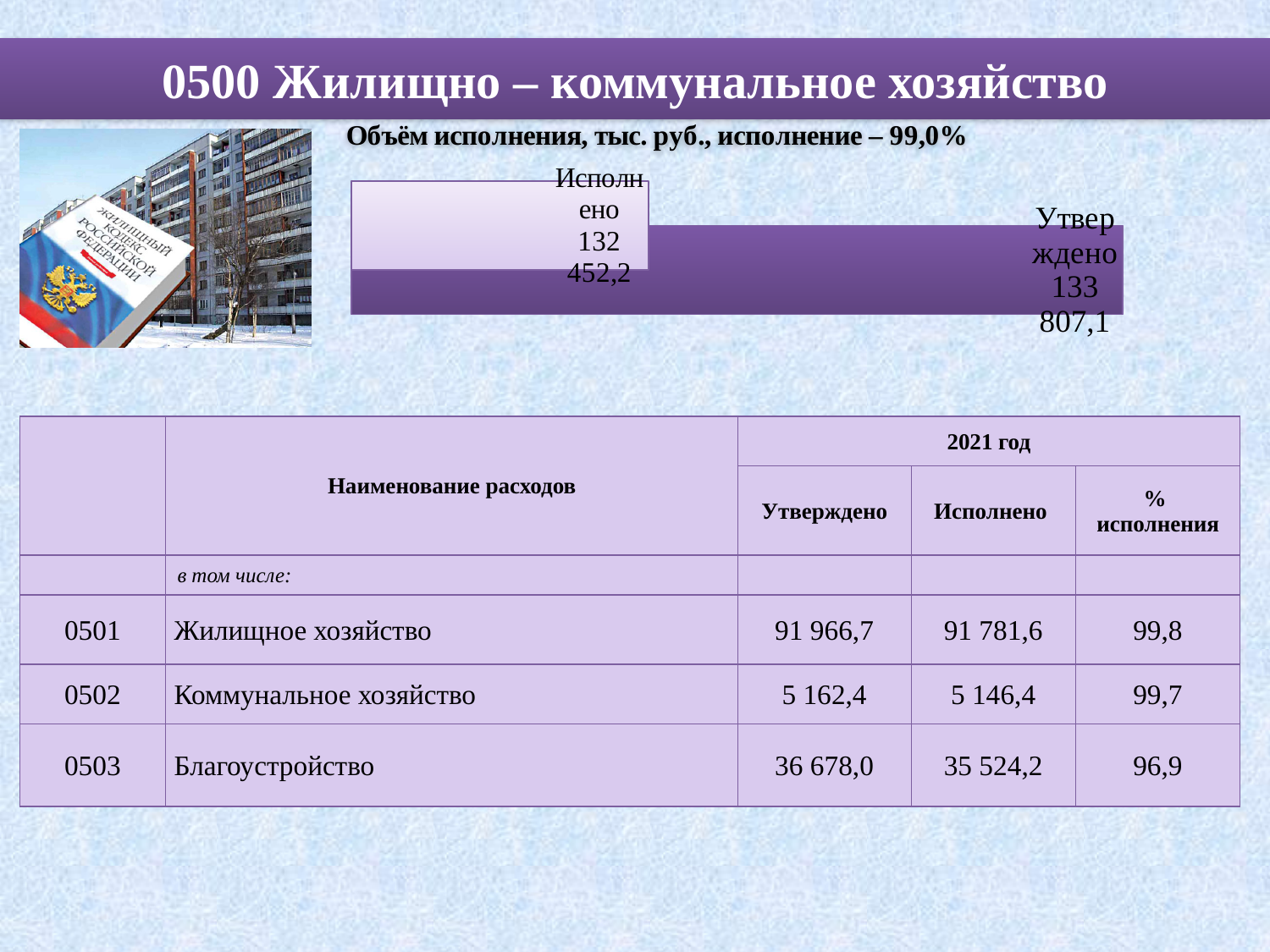
What execution percentage is stated in the chart title? 99,0% How many bars are plotted in the chart? 2 What value is shown for the bar labelled Утверждено? 133 807,1 What is the title of the chart? Объём исполнения, тыс. руб., исполнение – 99,0% What value is shown for the bar labelled Исполнено? 132 452,2 Which bar has the lower value in the chart? Исполнено Which bar has the higher value, Исполнено or Утверждено? Утверждено Is the Исполнено value larger or smaller than the Утверждено value? smaller What kind of chart is shown on the slide? bar chart What is the difference between the Утверждено value and the Исполнено value? 1 354,9